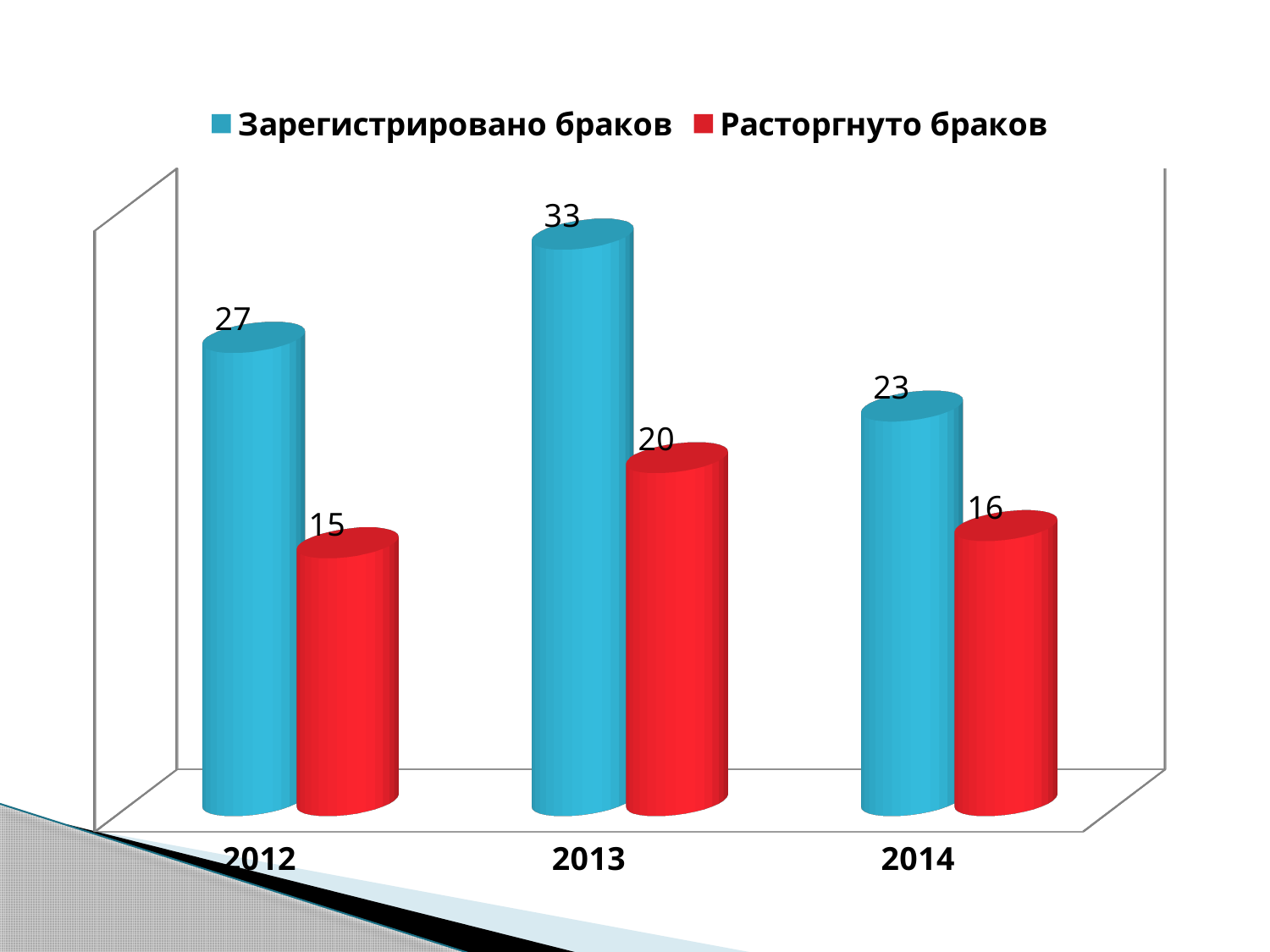
What is the value for Зарегистрировано браков in 2014? 23 What is the difference between registered and dissolved marriages in 2013? 13 Which colour represents Расторгнуто браков in the chart? Red How many marriages were registered (Зарегистрировано браков) in 2013? 33 How many marriages were dissolved (Расторгнуто браков) in 2012? 15 In which year was the number of registered marriages (Зарегистрировано браков) highest? 2013 Which is larger: dissolved marriages in 2014 or dissolved marriages in 2012? 2014 How many series does the legend list? 2 How many years are shown on the x axis? 3 What kind of chart is shown on the slide? Bar chart By how much did the number of registered marriages fall from 2013 to 2014? 10 In which year was the number of dissolved marriages (Расторгнуто браков) lowest? 2012